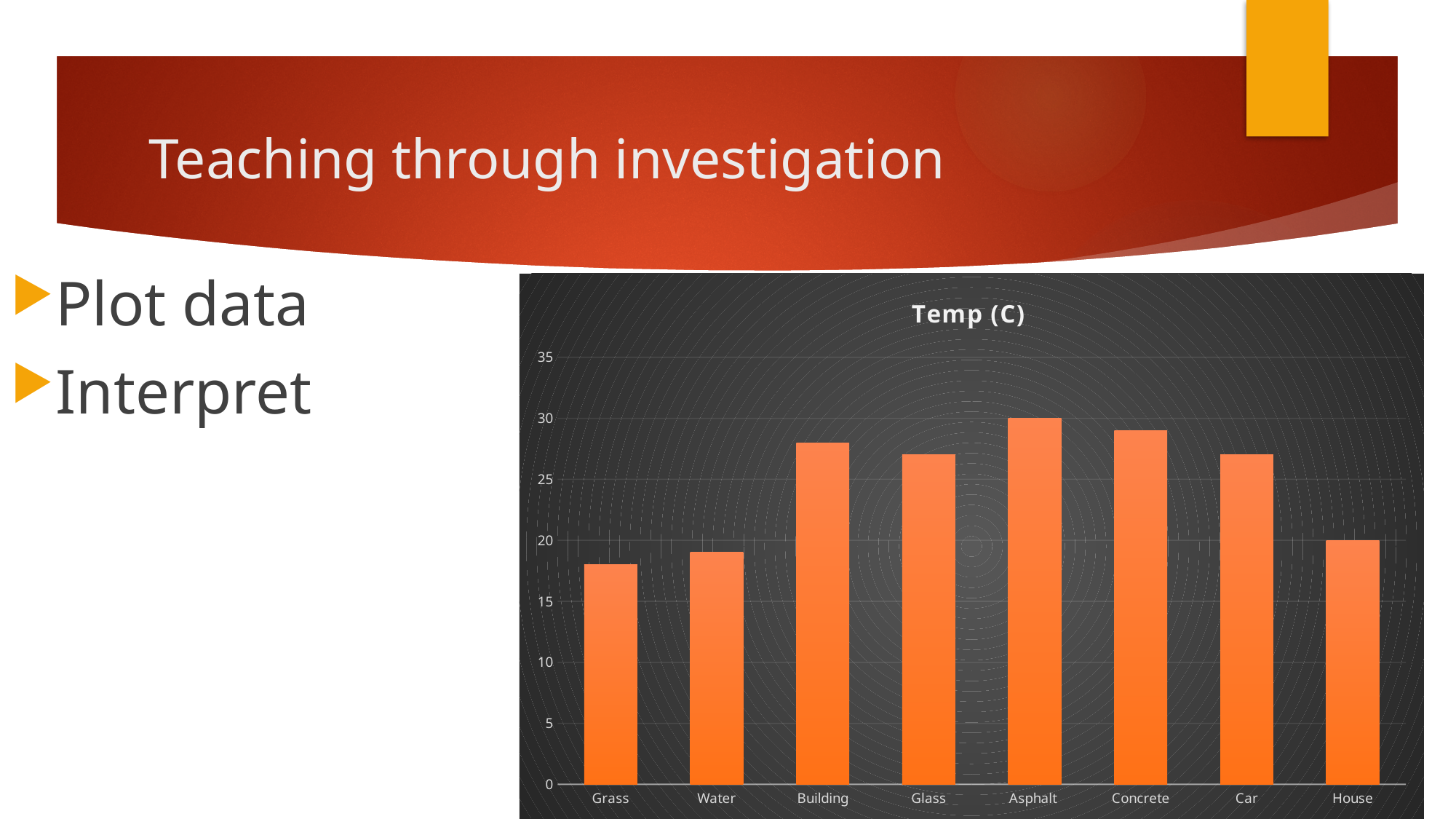
What type of chart is shown on the slide? bar chart What is the value for Asphalt? 30 How many categories are shown on the x axis of the chart? 8 Which category has the highest value in the chart? Asphalt Is the value for Water greater or less than 20? less Is the value for Grass greater or less than 20? less What is the value for House? 20 Is the value for Concrete greater or less than 30? less Which is larger, the value for House or the value for Car? Car What is the title of the chart? Temp (C) Which is larger, the value for Building or the value for Grass? Building